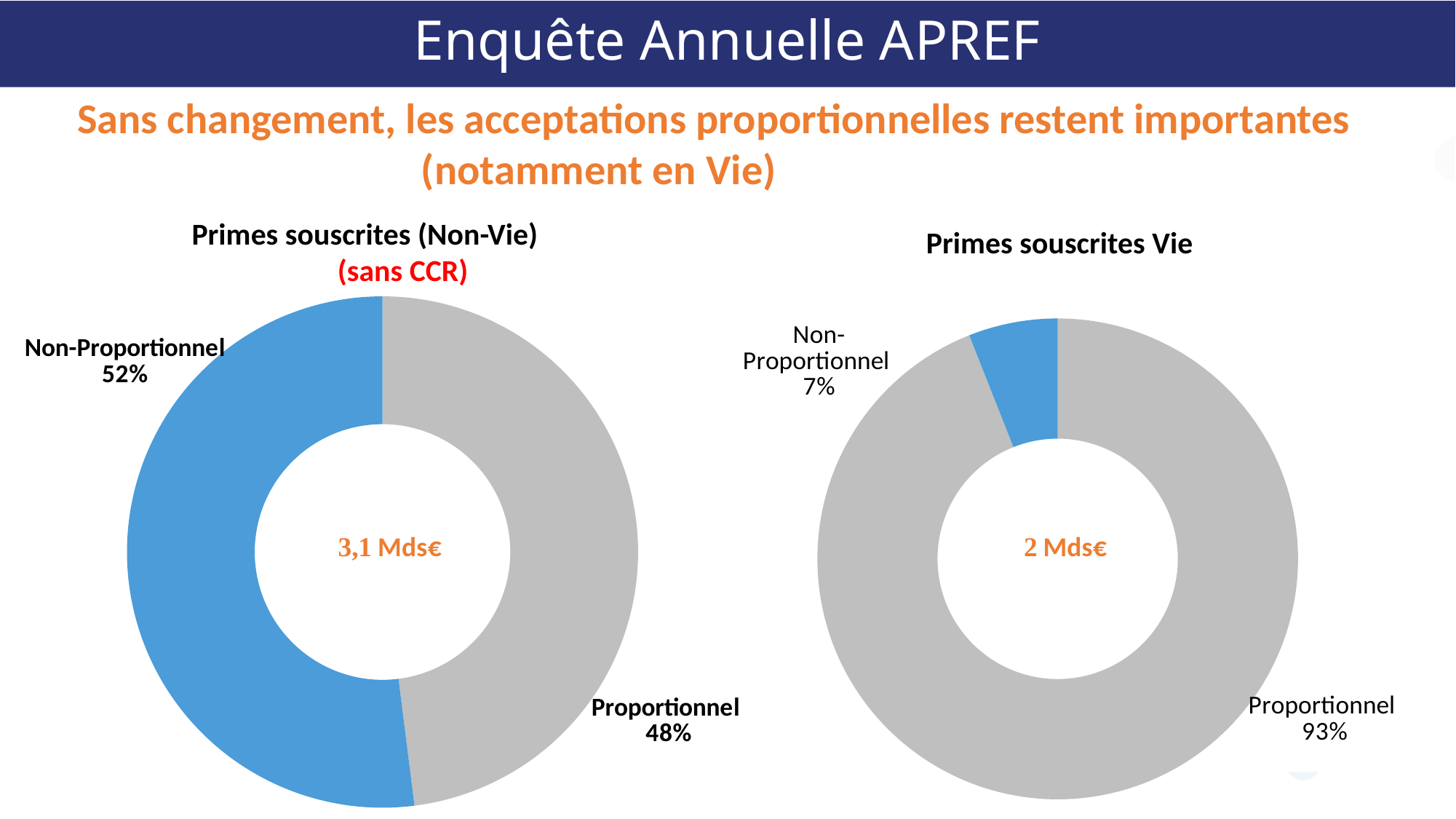
What total amount is shown in the centre of the 'Primes souscrites (Non-Vie)' chart? 3,1 Mds€ In the 'Primes souscrites Vie' chart, what share is Proportionnel? 93% In the 'Primes souscrites (Non-Vie)' chart, what share is Non-Proportionnel? 52% How many categories does the 'Primes souscrites Vie' chart show? 2 In the 'Primes souscrites (Non-Vie)' chart, what share is Proportionnel? 48% In the 'Primes souscrites (Non-Vie)' chart, which category has the smallest share? Proportionnel What total amount is shown in the centre of the 'Primes souscrites Vie' chart? 2 Mds€ In the 'Primes souscrites (Non-Vie)' chart, which is larger, Non-Proportionnel or Proportionnel? Non-Proportionnel In the 'Primes souscrites Vie' chart, which category has the largest share? Proportionnel In the 'Primes souscrites Vie' chart, what share is Non-Proportionnel? 7% In the 'Primes souscrites Vie' chart, what is the difference in percentage points between Proportionnel and Non-Proportionnel? 86 What kind of chart is 'Primes souscrites (Non-Vie)'? Doughnut chart